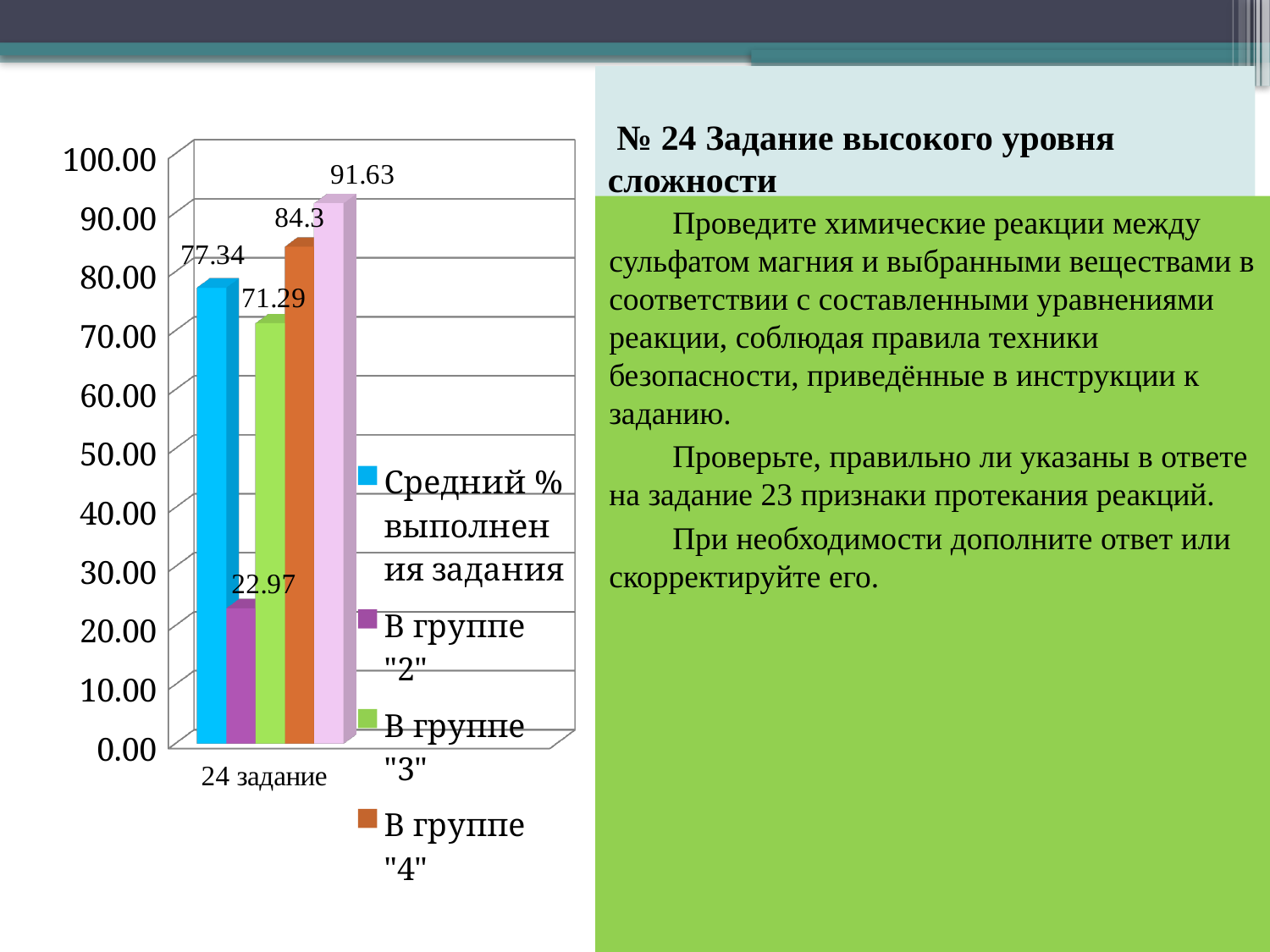
What is the difference between "Средний % выполнения задания" and "В группе "2""? 54.37 What kind of chart is shown on the slide? bar chart What is the value for the series "В группе "3""? 71.29 What is the value for the series "В группе "4""? 84.3 Is the value for "В группе "2"" greater or less than 30.00? less What is the difference between the values for "В группе "4"" and "В группе "3""? 13.01 What is the value for the series "Средний % выполнения задания"? 77.34 How many bars are plotted on the chart? 5 Which is larger: the value for "В группе "3"" or for "Средний % выполнения задания"? Средний % выполнения задания What is the value for the series "В группе "2""? 22.97 Which series has the lowest value on the chart? В группе "2" What is the highest value labelled on the chart? 91.63